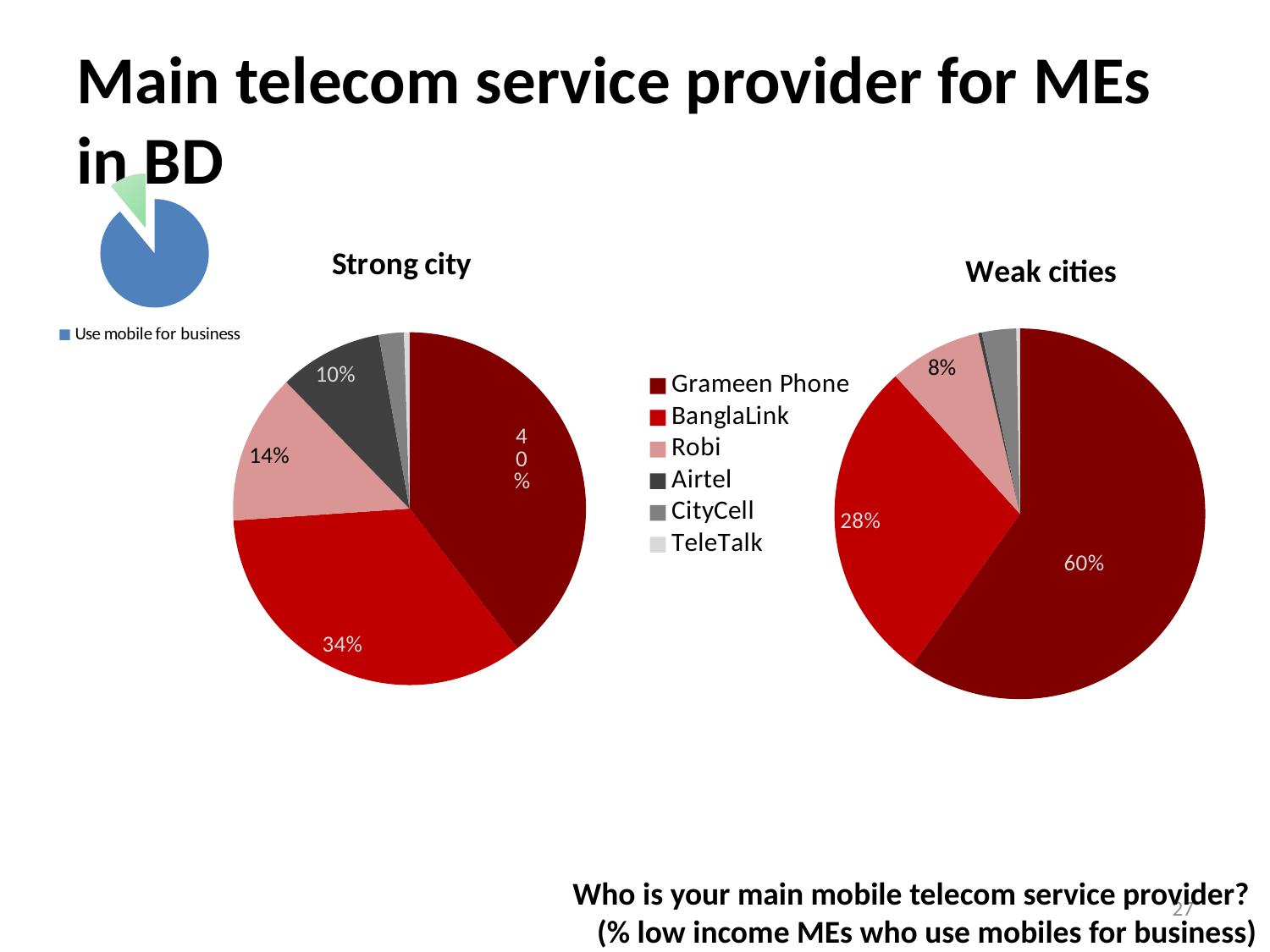
In the Weak cities pie chart, which provider has the largest share? Grameen Phone What type of chart is the Weak cities chart? Pie chart Is Grameen Phone's share larger in the Strong city chart or the Weak cities chart? Weak cities In the Weak cities pie chart, what share does BanglaLink hold? 28% In the Strong city pie chart, what is the difference between the Grameen Phone and BanglaLink shares? 6% How many providers does the shared legend between the Strong city and Weak cities charts list? 6 In the Strong city pie chart, what share does Robi hold? 14% In the Weak cities pie chart, what share does Grameen Phone hold? 60% In the Strong city pie chart, what share does Grameen Phone hold? 40% In the Strong city pie chart, what share does Airtel hold? 10% In the Strong city pie chart, what share does BanglaLink hold? 34% In the Weak cities pie chart, what share does Robi hold? 8%